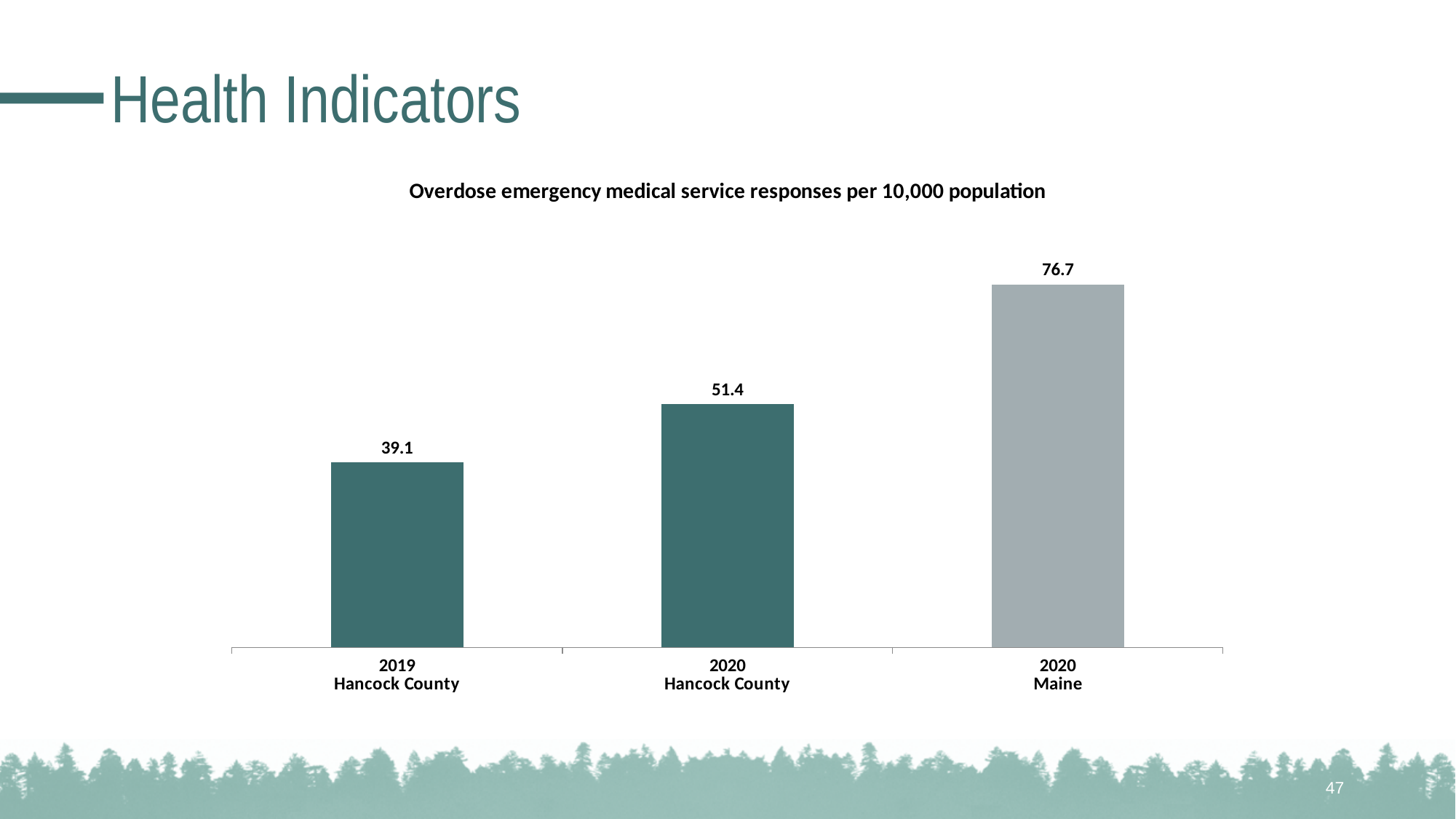
What is the value for 2019 Hancock County? 39.1 Which category has the lowest value? 2019 Hancock County Which category has the highest value? 2020 Maine Which is larger, the value for 2020 Hancock County or the value for 2020 Maine? 2020 Maine How many bars are shown in the chart? 3 What is the difference between the 2020 Hancock County value and the 2019 Hancock County value? 12.3 What is the value for 2020 Hancock County? 51.4 Do the values rise or fall from left to right across the chart? Rise What is the difference between the 2020 Maine value and the 2020 Hancock County value? 25.3 What is the value for 2020 Maine? 76.7 What kind of chart is shown on the slide? Bar chart What is the title of the chart? Overdose emergency medical service responses per 10,000 population